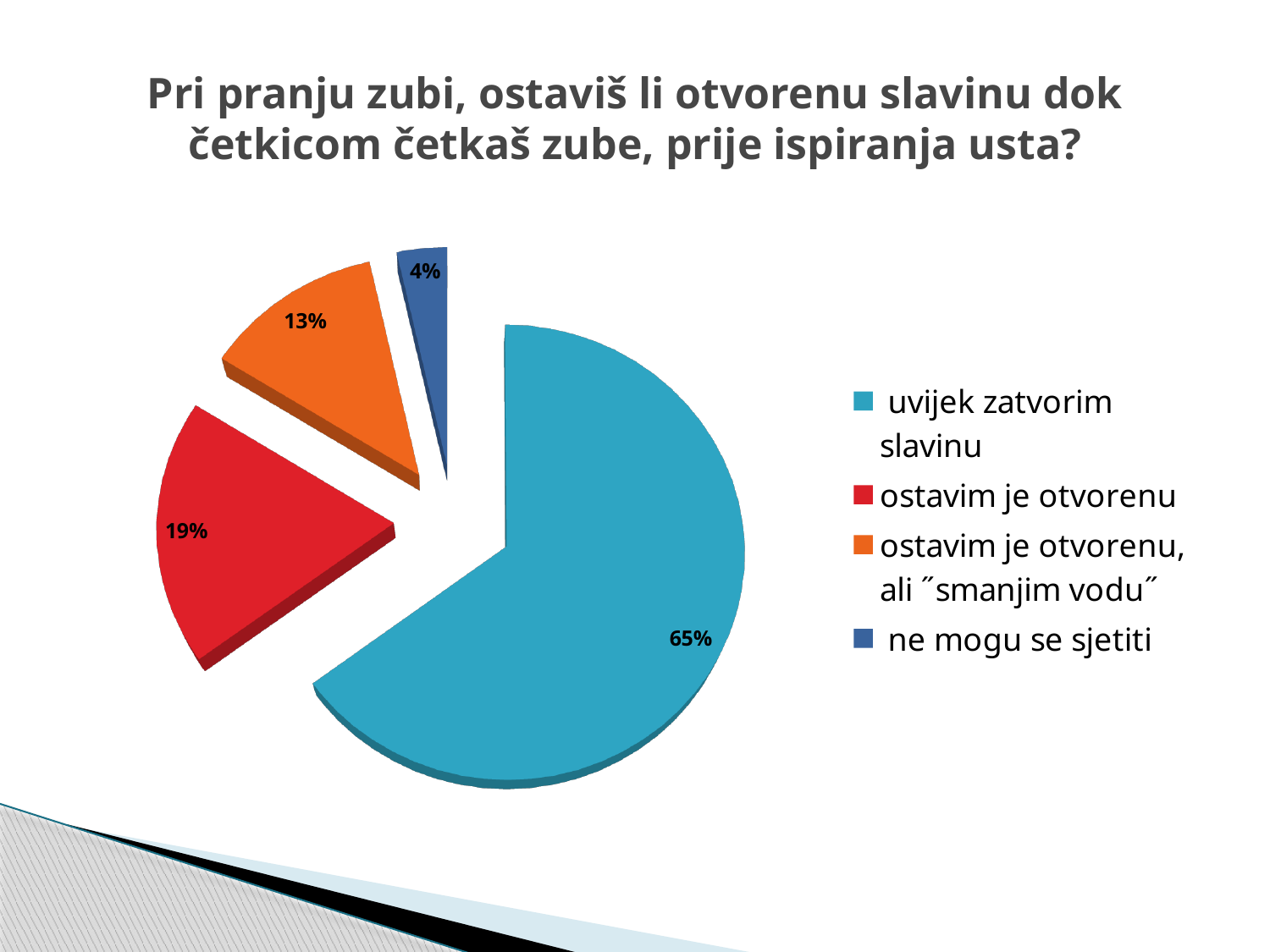
What share of the pie does "uvijek zatvorim slavinu" have? 65% What colour is the slice for "ostavim je otvorenu, ali ˝smanjim vodu˝"? orange What kind of chart is shown on the slide? pie chart How many categories does the pie chart have? 4 What is the value for "ne mogu se sjetiti"? 4% What is the difference between "ostavim je otvorenu" and "ostavim je otvorenu, ali ˝smanjim vodu˝"? 6% Which category has the smallest slice? ne mogu se sjetiti What is the difference between "uvijek zatvorim slavinu" and "ostavim je otvorenu"? 46% What is the value for "ostavim je otvorenu"? 19% Which is larger, "ostavim je otvorenu" or "ne mogu se sjetiti"? ostavim je otvorenu Which category has the largest slice? uvijek zatvorim slavinu What is the value for "ostavim je otvorenu, ali ˝smanjim vodu˝"? 13%